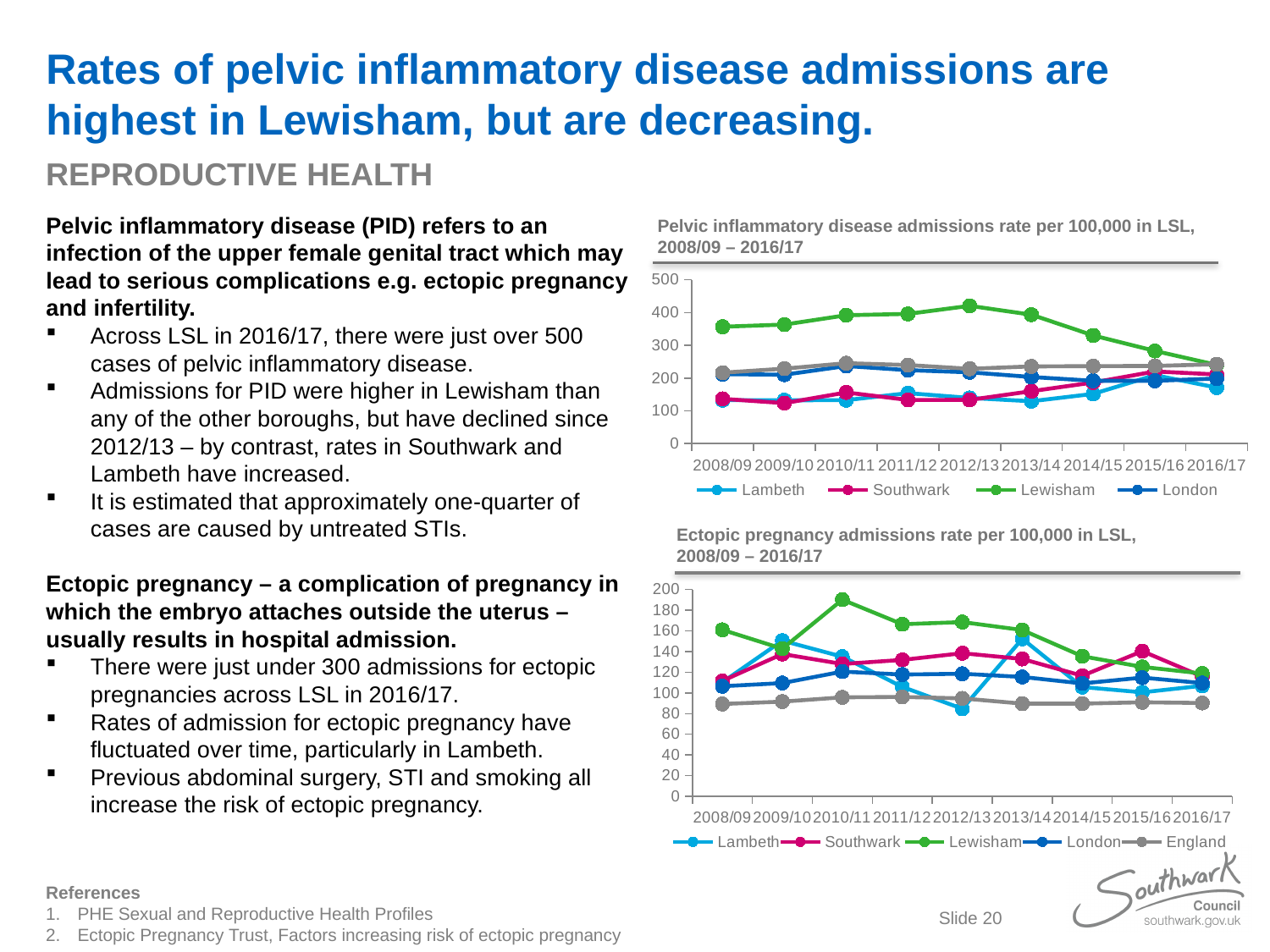
In the 'Ectopic pregnancy admissions rate' chart, is the value for Lambeth in 2012/13 greater or less than 100? less What type of chart is the 'Pelvic inflammatory disease admissions rate per 100,000 in LSL' chart? line chart In the 'Ectopic pregnancy admissions rate' chart, how many series does the legend list? 5 In the 'Pelvic inflammatory disease admissions rate' chart, how many series does the legend list? 4 In the 'Pelvic inflammatory disease admissions rate' chart, is the value for Lewisham in 2012/13 greater or less than 400? greater In the 'Pelvic inflammatory disease admissions rate' chart, which is higher in 2010/11: Lewisham or Southwark? Lewisham In the 'Pelvic inflammatory disease admissions rate' chart, is the value for Lambeth in 2016/17 greater or less than 200? less In the 'Ectopic pregnancy admissions rate' chart, which is higher in 2015/16: Southwark or London? Southwark In the 'Pelvic inflammatory disease admissions rate' chart, which borough has the highest rate in 2012/13? Lewisham In the 'Ectopic pregnancy admissions rate' chart, which series has the highest value in 2010/11? Lewisham In the 'Pelvic inflammatory disease admissions rate' chart, does the Lewisham line rise or fall between 2012/13 and 2016/17? fall How many time periods are shown on the x axis of the 'Pelvic inflammatory disease admissions rate' chart? 9